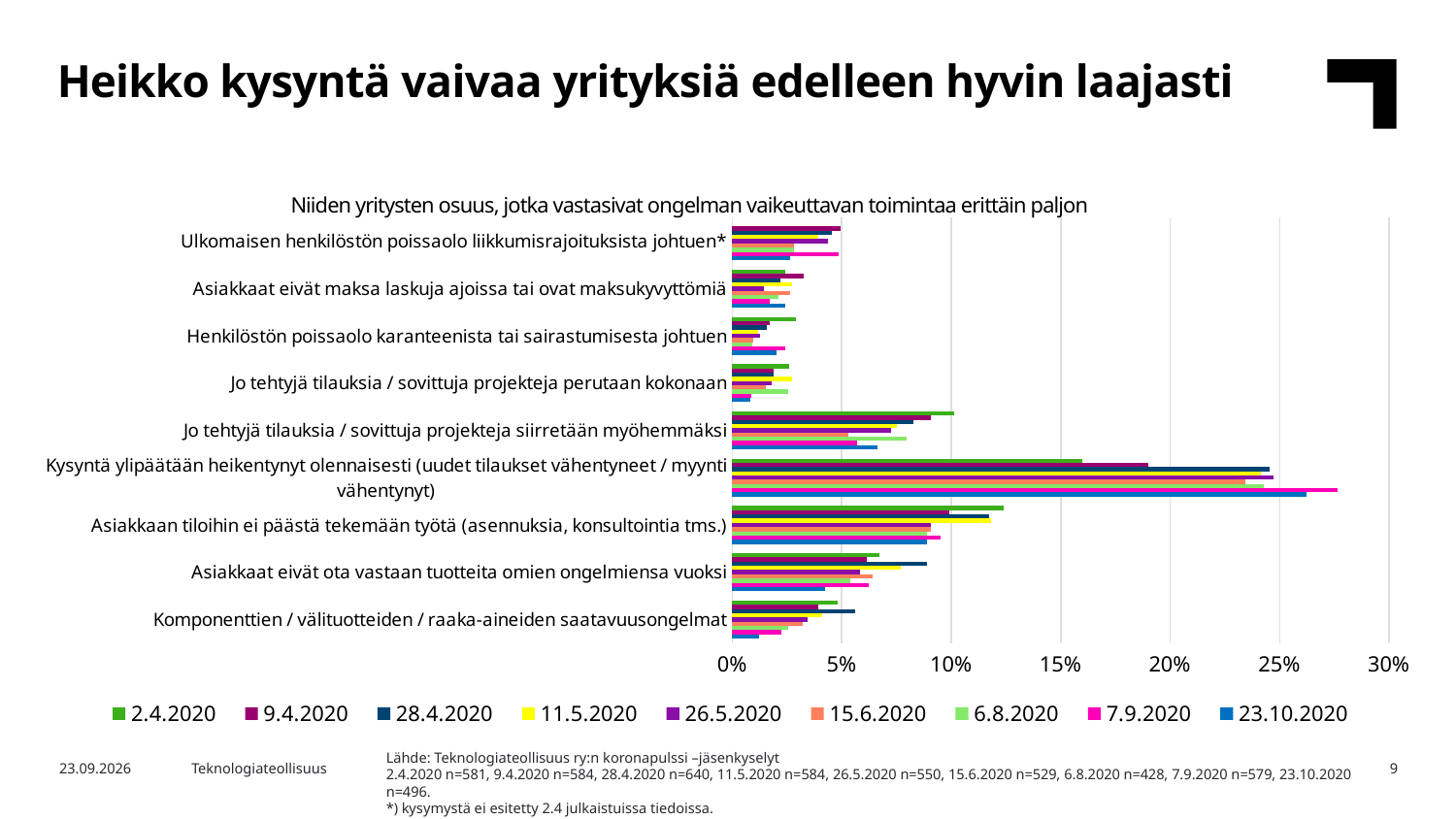
Is the 2.4.2020 value for 'Kysyntä ylipäätään heikentynyt olennaisesti' greater or less than 15%? greater Is the 7.9.2020 value for 'Kysyntä ylipäätään heikentynyt olennaisesti' greater or less than 25%? greater Is the 2.4.2020 value for 'Asiakkaan tiloihin ei päästä tekemään työtä' greater or less than 10%? greater For the 2.4.2020 series, which is larger: 'Asiakkaan tiloihin ei päästä tekemään työtä' or 'Asiakkaat eivät ota vastaan tuotteita omien ongelmiensa vuoksi'? Asiakkaan tiloihin ei päästä tekemään työtä What is the title of the chart? Niiden yritysten osuus, jotka vastasivat ongelman vaikeuttavan toimintaa erittäin paljon For 'Kysyntä ylipäätään heikentynyt olennaisesti', which is larger: the 7.9.2020 value or the 2.4.2020 value? 7.9.2020 Which category has the highest values on the chart? Kysyntä ylipäätään heikentynyt olennaisesti (uudet tilaukset vähentyneet / myynti vähentynyt) What is the last series listed in the chart legend? 23.10.2020 What kind of chart is shown on the slide? bar chart How many categories (problem types) are plotted on the chart? 9 How many series does the chart legend list? 9